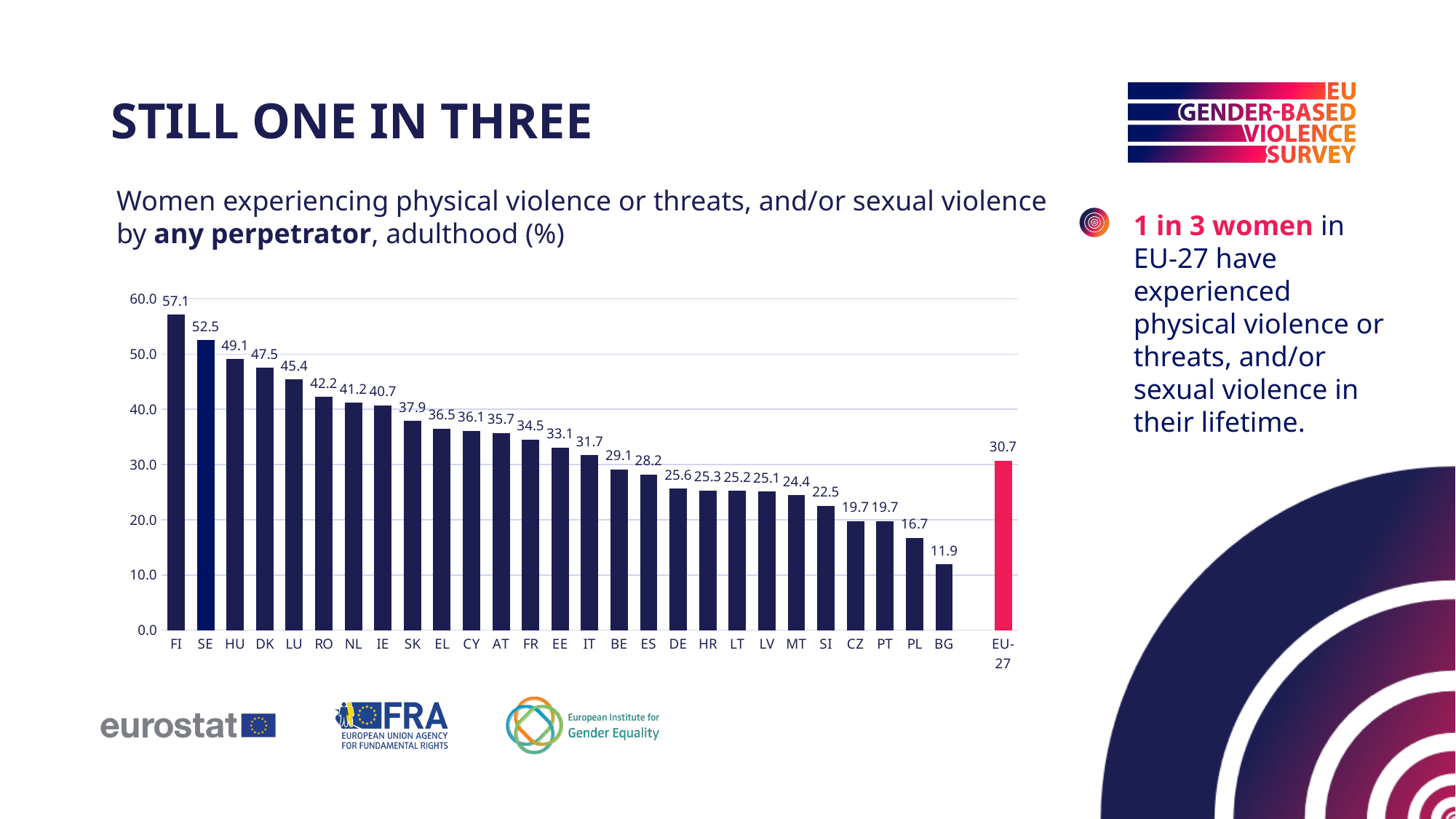
Which has a larger value, HU or LU? HU How many bars are plotted in the chart? 28 What is the value for DE? 25.6 What is the value for the EU-27 bar? 30.7 Which country has the lowest value? BG What is the value for FI? 57.1 Which bar is shown in a different colour (pink) from the others? EU-27 What is the difference between the values for EU-27 and BG? 18.8 Is the value for SK greater or less than 40.0? less Which country has the highest value? FI What is the difference between the values for FI and SE? 4.6 What kind of chart is shown on the slide? bar chart